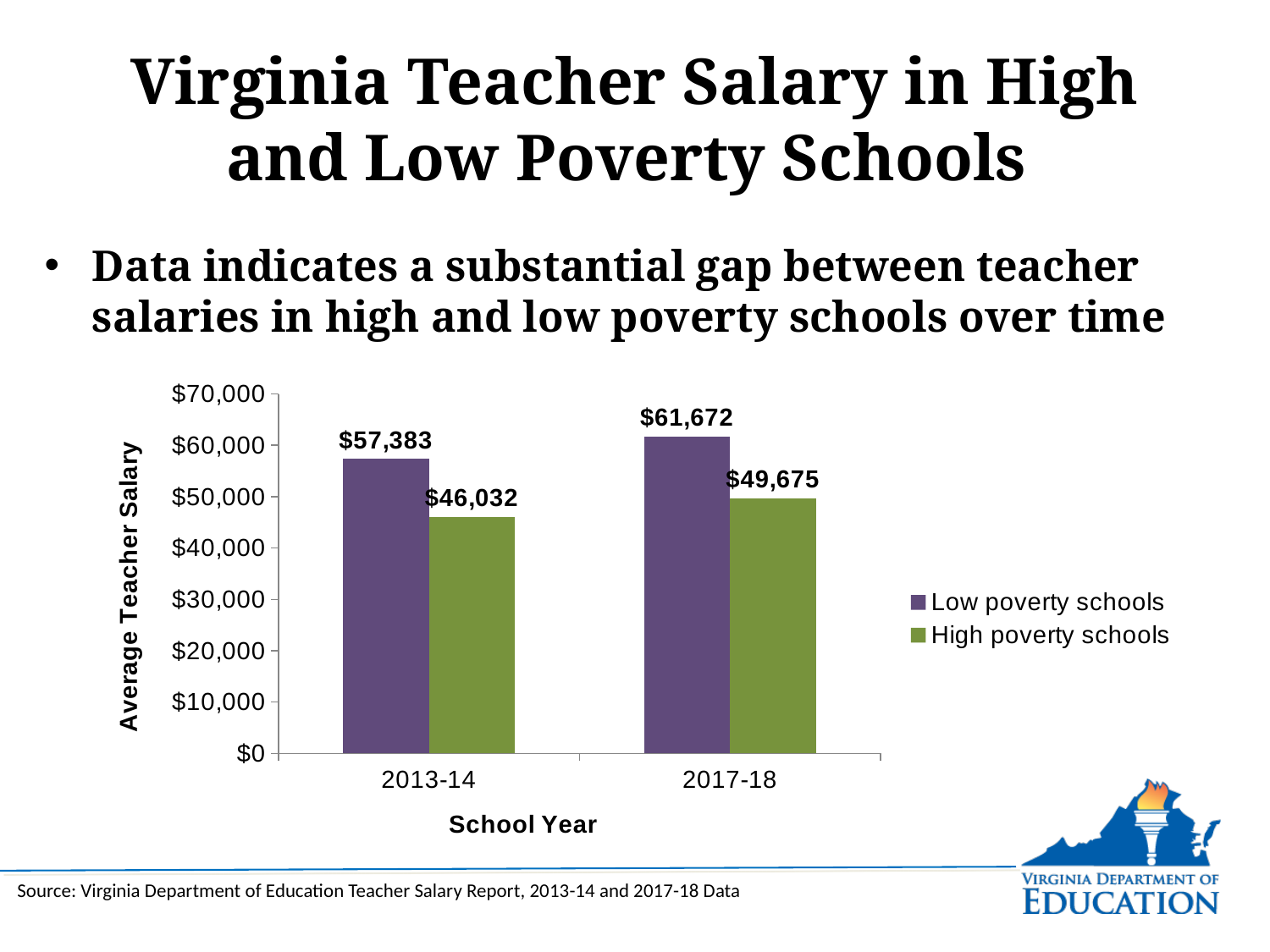
What is the average teacher salary for high poverty schools in 2017-18? $49,675 How many series does the legend list? 2 Which bar shows the lowest average teacher salary on the chart? High poverty schools, 2013-14 Which bar shows the highest average teacher salary on the chart? Low poverty schools, 2017-18 Which is larger: the high poverty school salary in 2017-18 or the low poverty school salary in 2013-14? Low poverty school salary in 2013-14 What is the average teacher salary for low poverty schools in 2013-14? $57,383 What is the average teacher salary for low poverty schools in 2017-18? $61,672 How many school years are shown on the x axis? 2 What is the difference between the low poverty and high poverty school salaries in 2017-18? $11,997 What type of chart is shown on the slide? Bar chart What is the average teacher salary for high poverty schools in 2013-14? $46,032 By how much did the average salary for low poverty schools increase from 2013-14 to 2017-18? $4,289